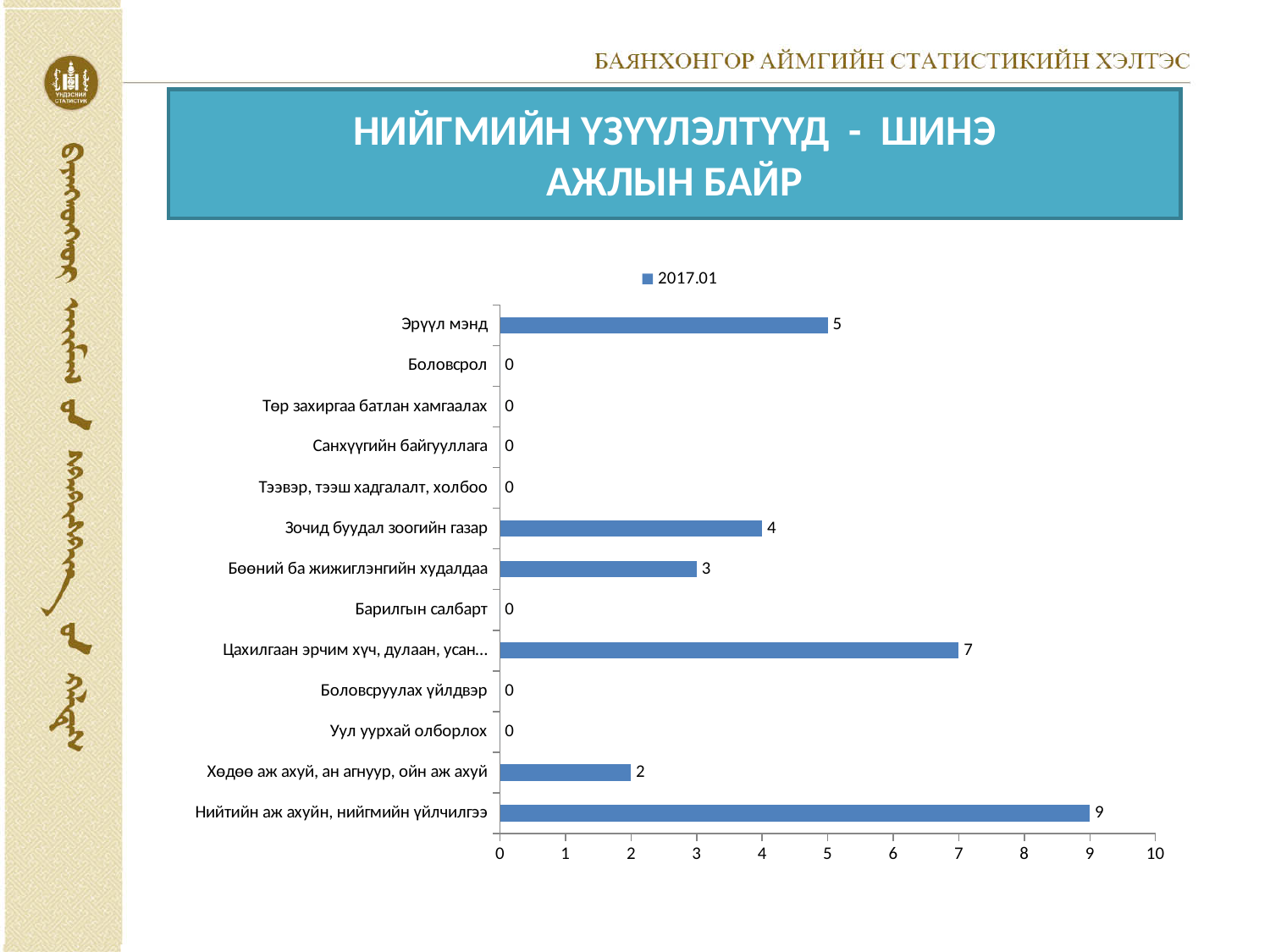
What is the value for Нийтийн аж ахуйн, нийгмийн үйлчилгээ? 9 What is the value for Боловсрол? 0 What is the value for Хөдөө аж ахуй, ан агнуур, ойн аж ахуй? 2 What is the value for Эрүүл мэнд? 5 What is the difference between the values for Нийтийн аж ахуйн, нийгмийн үйлчилгээ and Эрүүл мэнд? 4 Which category has the highest value? Нийтийн аж ахуйн, нийгмийн үйлчилгээ How many categories are shown on the chart? 13 What is the value for Зочид буудал зоогийн газар? 4 How many series does the legend list? 1 What kind of chart is shown on the slide? bar chart What series name is shown in the legend? 2017.01 Which is larger, the value for Бөөний ба жижиглэнгийн худалдаа or the value for Зочид буудал зоогийн газар? Зочид буудал зоогийн газар